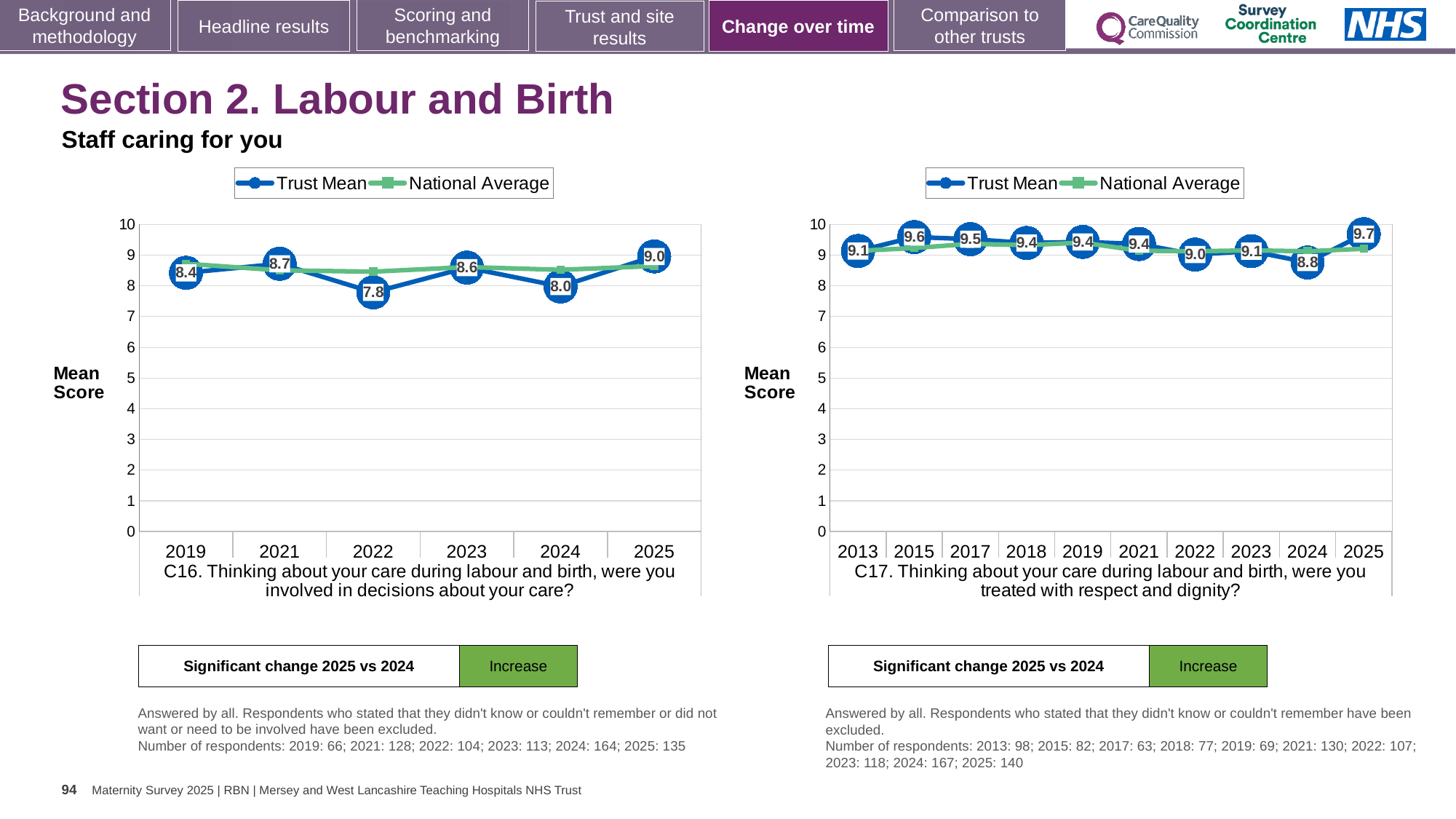
In the left chart (C16), which year has the highest Trust Mean score? 2025 What kind of chart is the left chart (C16)? Line chart In the left chart (C16), what is the Trust Mean score for 2022? 7.8 In the right chart (C17), what is the Trust Mean score for 2024? 8.8 In the right chart (C17), which year has the lowest Trust Mean score? 2024 What does the box below the right chart (C17) say about the significant change 2025 vs 2024? Increase In the left chart (C16), does the Trust Mean rise or fall from 2024 to 2025? Rise How many series does the legend of the left chart (C16) list? 2 In the left chart (C16), is the National Average value for 2022 greater or less than 8? greater How many years are plotted in the right chart (C17)? 10 In the left chart (C16), what is the difference between the Trust Mean scores for 2025 and 2024? 1.0 In the right chart (C17), which is larger, the Trust Mean score for 2015 or for 2017? 2015